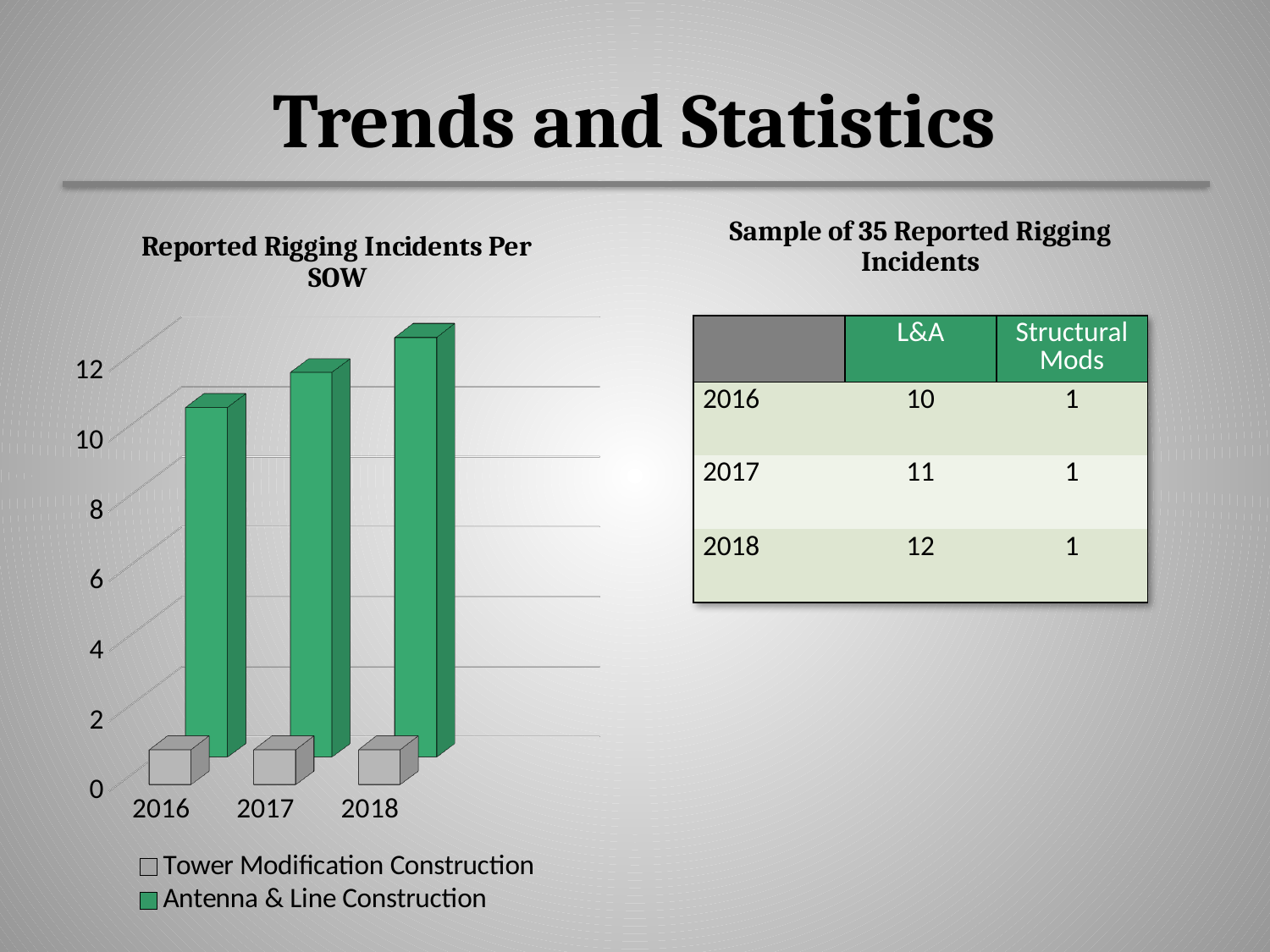
Which year has the lowest value for Antenna & Line Construction? 2016 Do the Antenna & Line Construction values rise or fall from 2016 to 2018? rise How many years are shown on the x axis of the chart? 3 How many series does the legend of the chart list? 2 What is the title of the chart? Reported Rigging Incidents Per SOW Which series is shown in green in the chart? Antenna & Line Construction Which year has the highest value for Antenna & Line Construction? 2018 Is the Antenna & Line Construction value for 2018 greater or less than 10? greater Which is larger in 2018: the Antenna & Line Construction bar or the Tower Modification Construction bar? Antenna & Line Construction What kind of chart is shown on the slide? bar chart Is the Tower Modification Construction value for 2017 greater or less than 2? less Is the Antenna & Line Construction value for 2016 greater or less than 8? greater